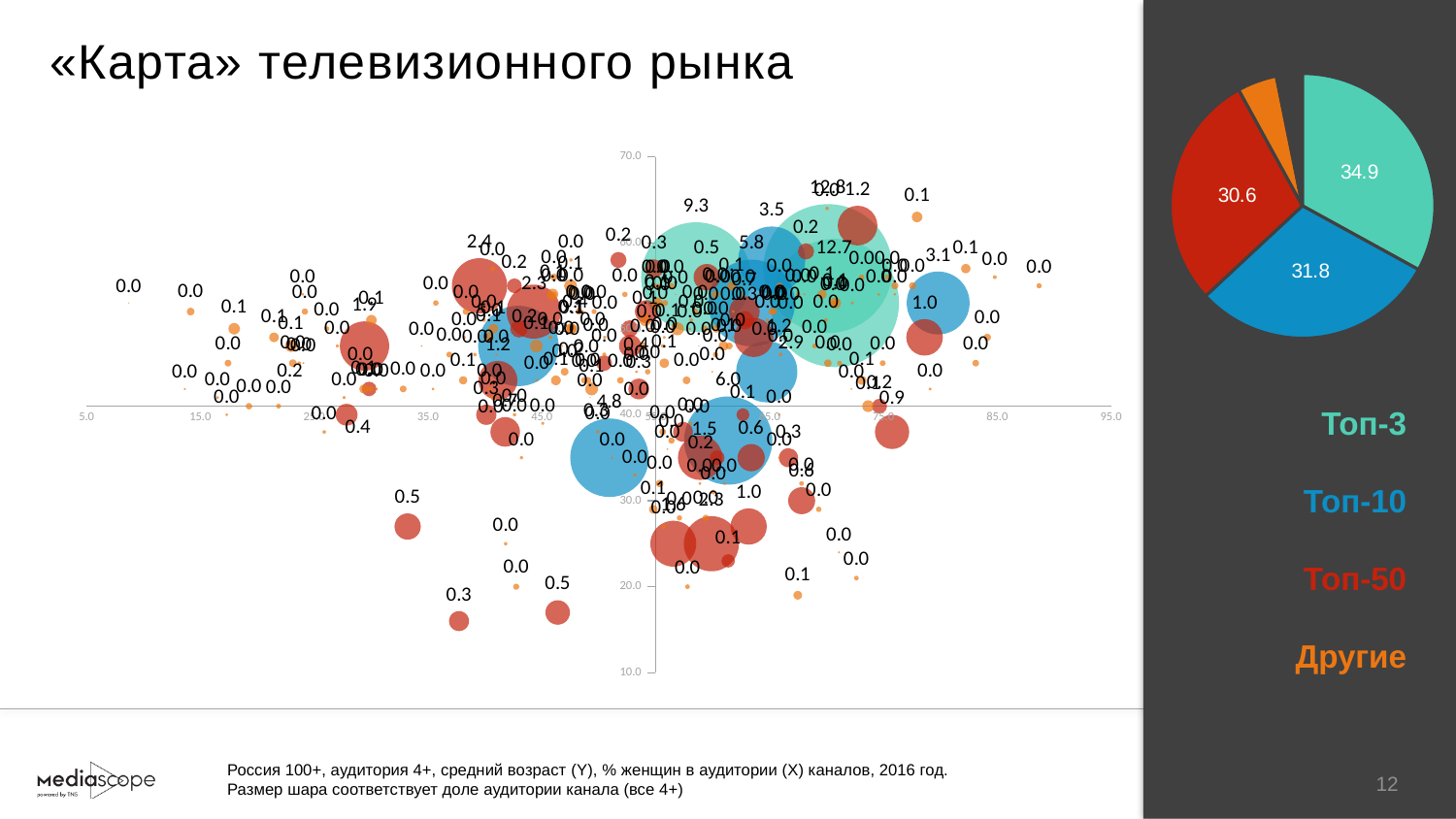
In the pie chart on the right, what is the difference between the Топ-10 value and the Топ-50 value? 1.2 What kind of chart is shown on the right side of the slide? Pie chart What kind of chart is the large chart titled «Карта» телевизионного рынка? Bubble chart How many groups does the legend next to the pie chart list? 4 In the pie chart on the right, what is the value shown for the Топ-50 slice? 30.6 In the pie chart on the right, what is the difference between the Топ-3 value and the Топ-10 value? 3.1 In the chart titled «Карта» телевизионного рынка, what is the highest tick value shown on the vertical axis? 70.0 In the pie chart on the right, what is the value shown for the Топ-3 slice? 34.9 In the pie chart on the right, which group has the smallest slice? Другие In the pie chart on the right, which is larger: the Топ-10 slice or the Топ-50 slice? Топ-10 In the pie chart on the right, what is the value shown for the Топ-10 slice? 31.8 In the pie chart on the right, which group has the largest slice? Топ-3